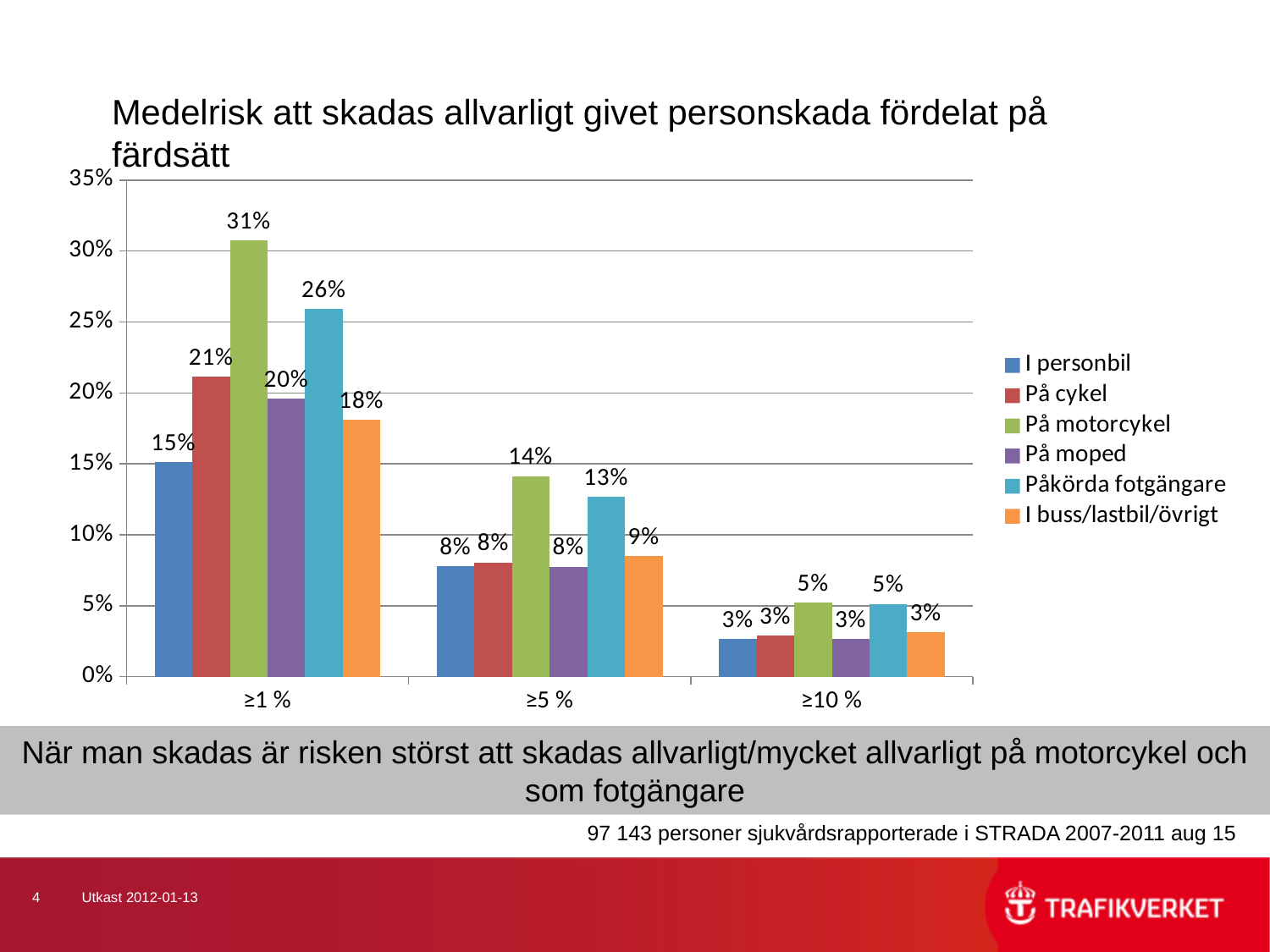
In the ≥5 % category, which is larger: På motorcykel or I buss/lastbil/övrigt? På motorcykel Which series has the lowest value in the ≥1 % category? I personbil Is the value for På cykel in the ≥1 % category greater or less than 20%? greater What is the value for I buss/lastbil/övrigt in the ≥1 % category? 18% What is the value for Påkörda fotgängare in the ≥5 % category? 13% Do the values for På motorcykel rise or fall from ≥1 % to ≥10 %? fall How many series does the legend list? 6 Which series has the highest value in the ≥1 % category? På motorcykel What is the difference between På motorcykel and Påkörda fotgängare in the ≥1 % category? 5% What kind of chart is shown on the slide? bar chart What is the value for På motorcykel in the ≥1 % category? 31% How many categories are shown on the x axis? 3